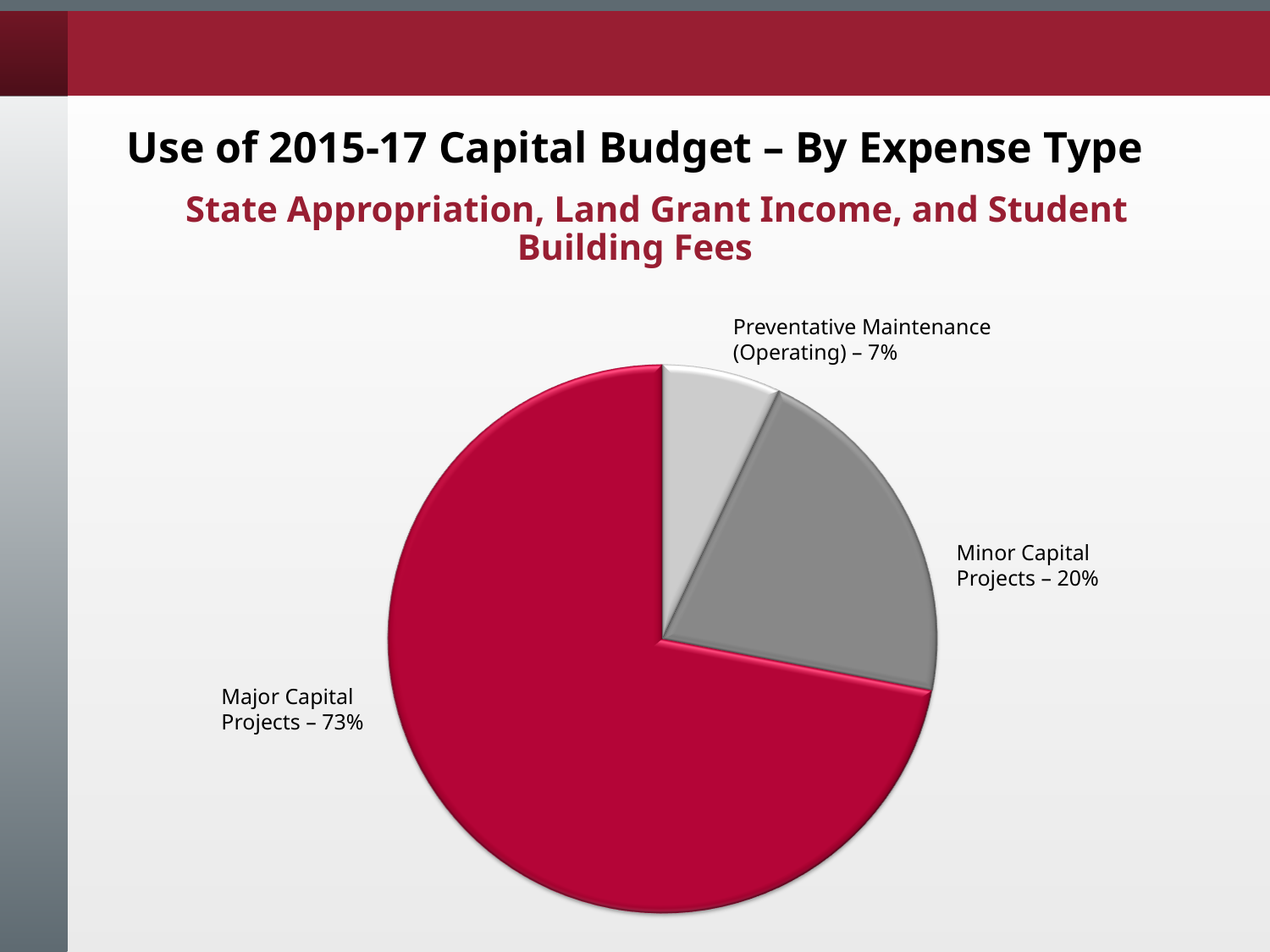
What is the title of the chart on the slide? Use of 2015-17 Capital Budget – By Expense Type What share of the 2015-17 capital budget goes to Minor Capital Projects? 20% Which is larger: the share for Minor Capital Projects or the share for Preventative Maintenance (Operating)? Minor Capital Projects What type of chart is shown on the slide? pie chart How many slices does the pie chart have? 3 What colour is the Major Capital Projects slice? red What share of the 2015-17 capital budget goes to Preventative Maintenance (Operating)? 7% Which expense type has the smallest share of the capital budget? Preventative Maintenance (Operating) What is the difference in percentage points between Major Capital Projects and Minor Capital Projects? 53 What share of the 2015-17 capital budget goes to Major Capital Projects? 73% What is the difference in percentage points between Minor Capital Projects and Preventative Maintenance (Operating)? 13 Which expense type has the largest share of the capital budget? Major Capital Projects